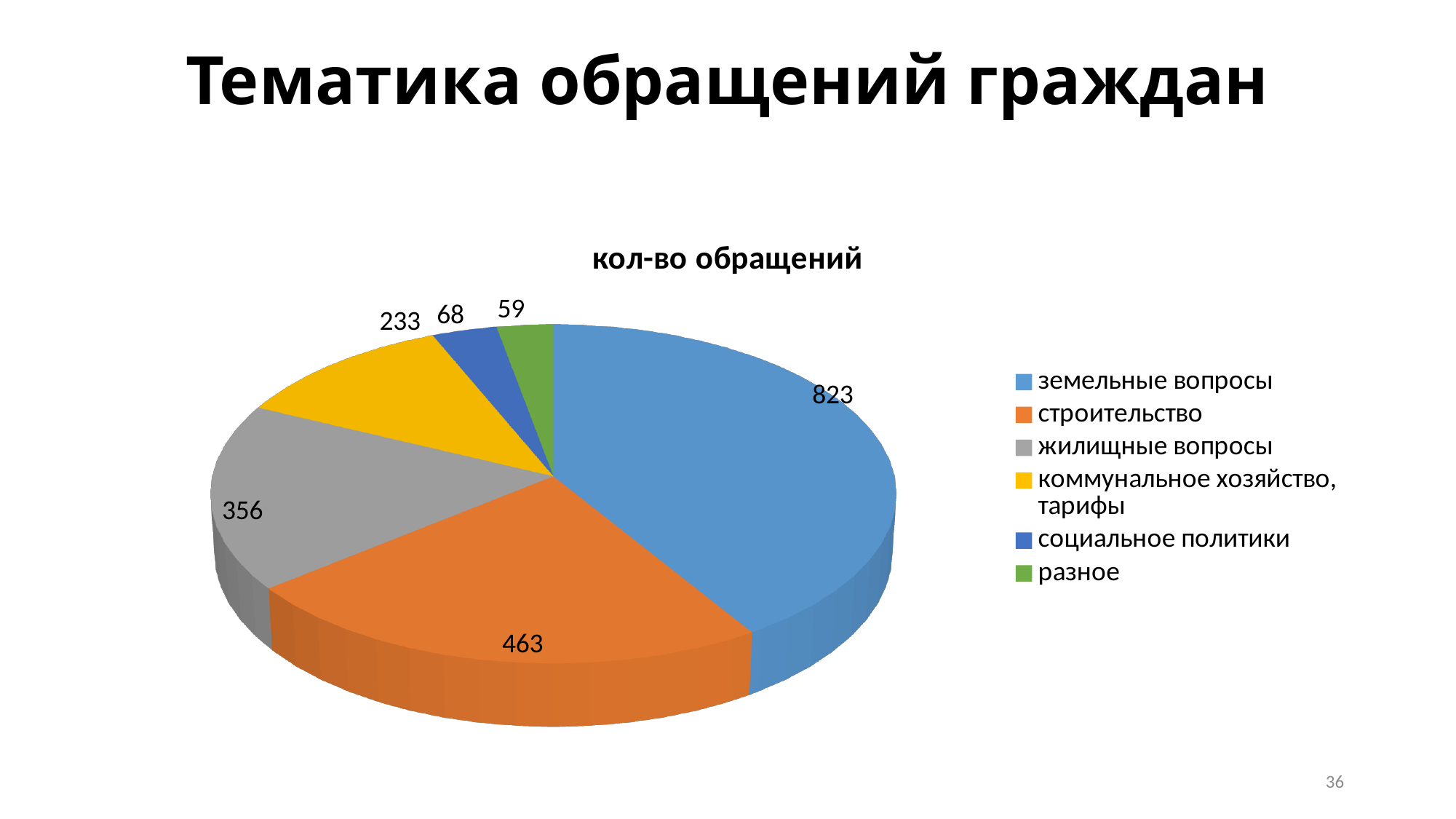
Which category has the largest slice? земельные вопросы What is the value for разное? 59 Which category has the smallest slice? разное What is the value for коммунальное хозяйство, тарифы? 233 What is the difference between the values for земельные вопросы and строительство? 360 What is the value for земельные вопросы? 823 What colour is the slice for социальное политики? blue What is the title of the chart? кол-во обращений What kind of chart is shown on the slide? pie chart What is the value for строительство? 463 How many categories does the pie chart have? 6 Which is larger, жилищные вопросы or коммунальное хозяйство, тарифы? жилищные вопросы